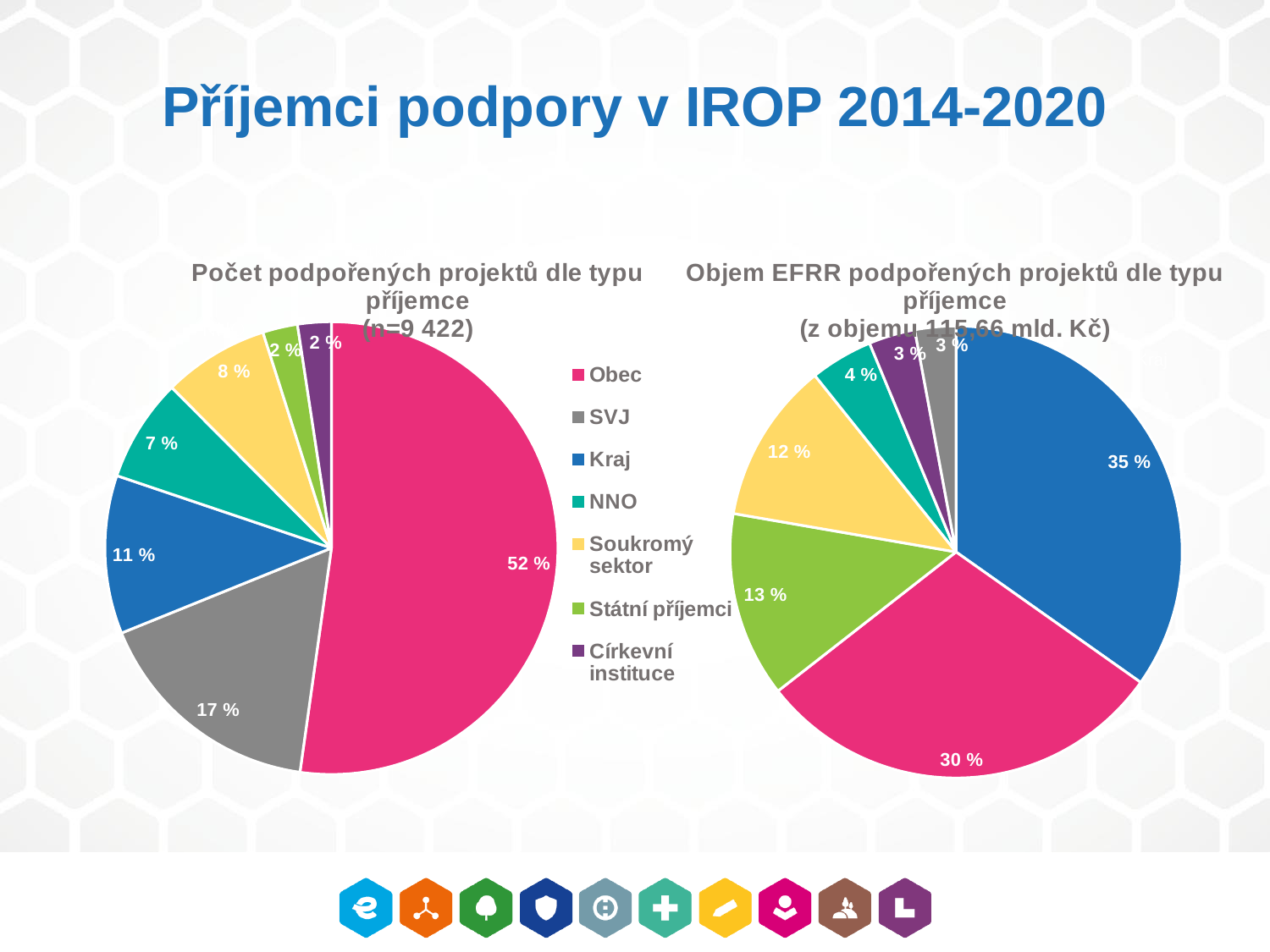
What colour represents Soukromý sektor in the charts? Yellow In the right chart (Objem EFRR podpořených projektů dle typu příjemce), which is larger, the share of Obec or the share of Soukromý sektor? Obec In the right chart (Objem EFRR podpořených projektů dle typu příjemce), what share does Kraj have? 35 % In the left chart (Počet podpořených projektů dle typu příjemce), what share of projects is for Obec? 52 % In the right chart (Objem EFRR podpořených projektů dle typu příjemce), what is the difference between the shares of Kraj and Obec? 5 % In the right chart (Objem EFRR podpořených projektů dle typu příjemce), which recipient type has the largest share? Kraj What type of chart is used on this slide? Pie chart In the left chart (Počet podpořených projektů dle typu příjemce), what share of projects is for SVJ? 17 % How many recipient types does the legend list? 7 In the right chart (Objem EFRR podpořených projektů dle typu příjemce), what share does Státní příjemci have? 13 % In the left chart (Počet podpořených projektů dle typu příjemce), what is the difference between the shares of Kraj and NNO? 4 % In the left chart (Počet podpořených projektů dle typu příjemce), which recipient type has the largest share? Obec